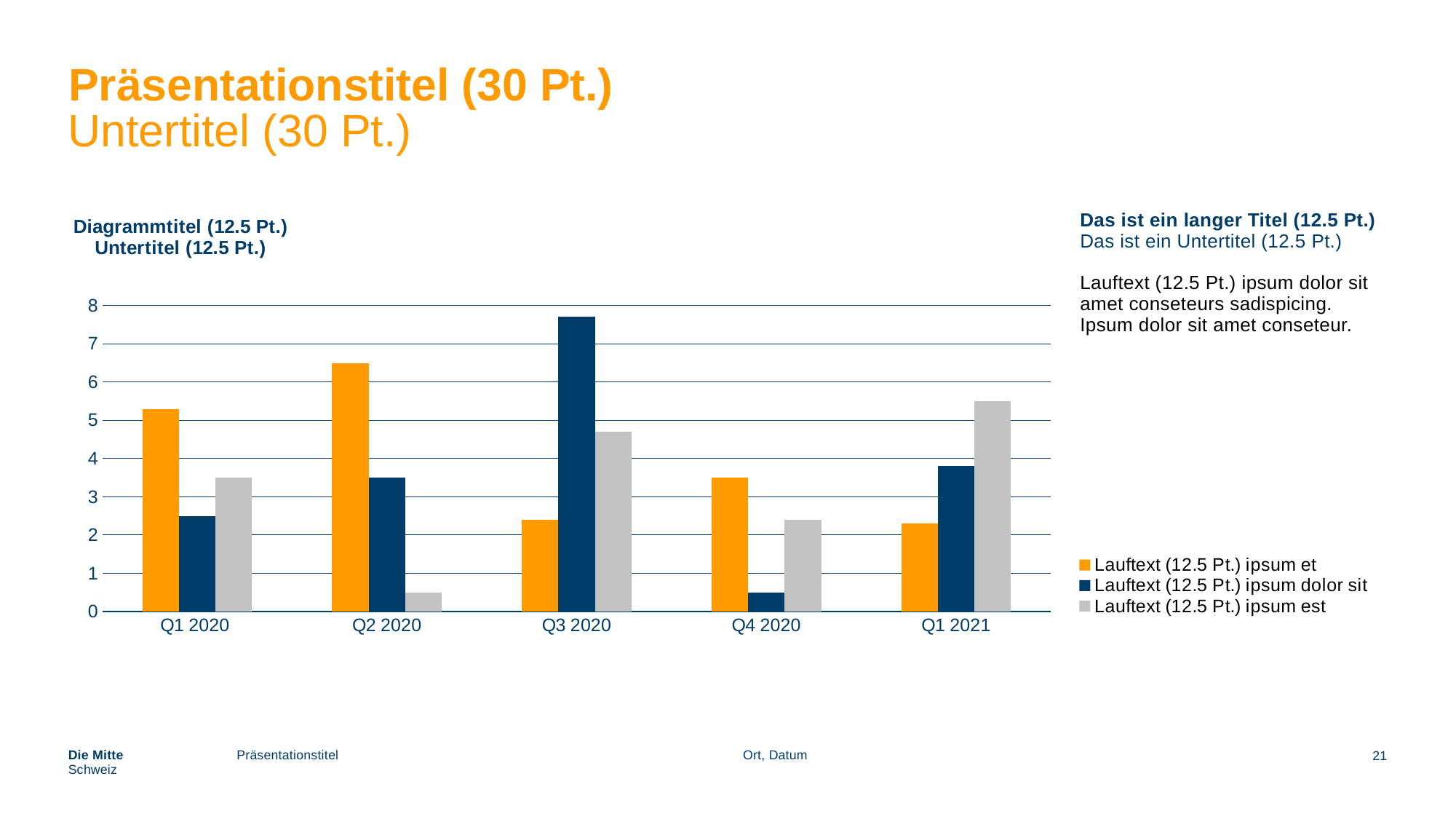
Is the value of the orange series for Q1 2020 greater or less than 4? greater How many series does the chart's legend list? 3 For Q1 2021, which is larger: the orange series or the grey series? the grey series In which category is the 'Lauftext (12.5 Pt.) ipsum est' (grey) series highest? Q1 2021 Which category has the tallest bar in the whole chart? Q3 2020 Is the value of the grey series for Q2 2020 greater or less than 1? less How many categories are shown on the x axis of the chart? 5 What kind of chart is shown on the slide? bar chart Does the orange series rise or fall from Q2 2020 to Q3 2020? fall Is the value of the dark blue series for Q3 2020 greater or less than 7? greater In which category is the 'Lauftext (12.5 Pt.) ipsum et' (orange) series highest? Q2 2020 In which category is the 'Lauftext (12.5 Pt.) ipsum dolor sit' (dark blue) series lowest? Q4 2020